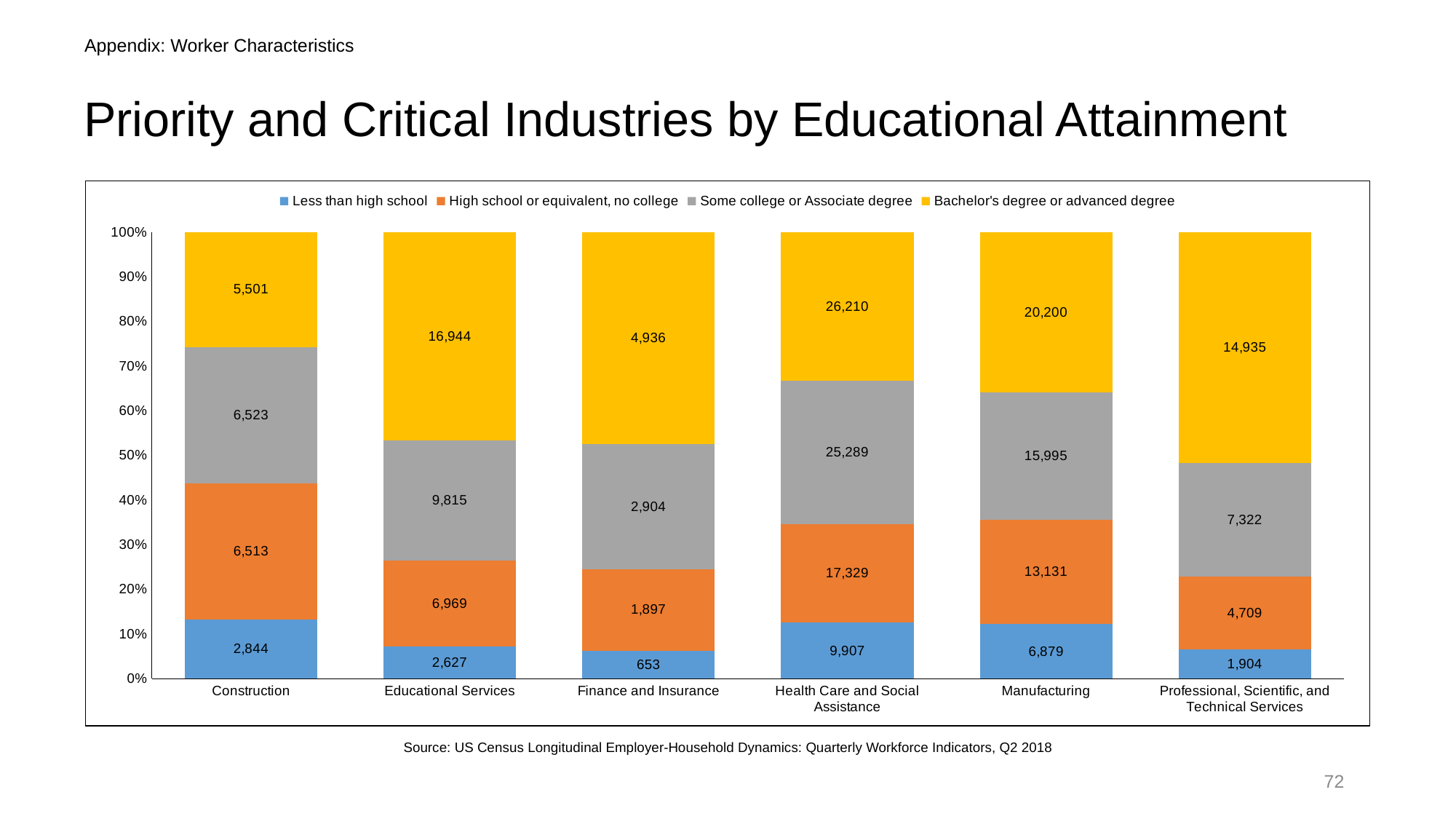
How many industries are shown on the x axis? 6 What kind of chart is shown on the slide? Stacked bar chart Which industry has the highest value for Less than high school? Health Care and Social Assistance How many workers with less than high school education are in Health Care and Social Assistance? 9,907 What is the value for Bachelor's degree or advanced degree in Educational Services? 16,944 Which industry has the lowest value for Some college or Associate degree? Finance and Insurance What is the total number of workers across all four education levels in Finance and Insurance? 10,390 Which is larger: the Bachelor's degree or advanced degree value for Construction or for Finance and Insurance? Construction Is the share of Less than high school workers in Construction greater or less than 10%? greater How many series does the legend list? 4 What is the value for High school or equivalent, no college in Finance and Insurance? 1,897 What is the difference between the Bachelor's degree or advanced degree value and the Some college or Associate degree value in Manufacturing? 4,205